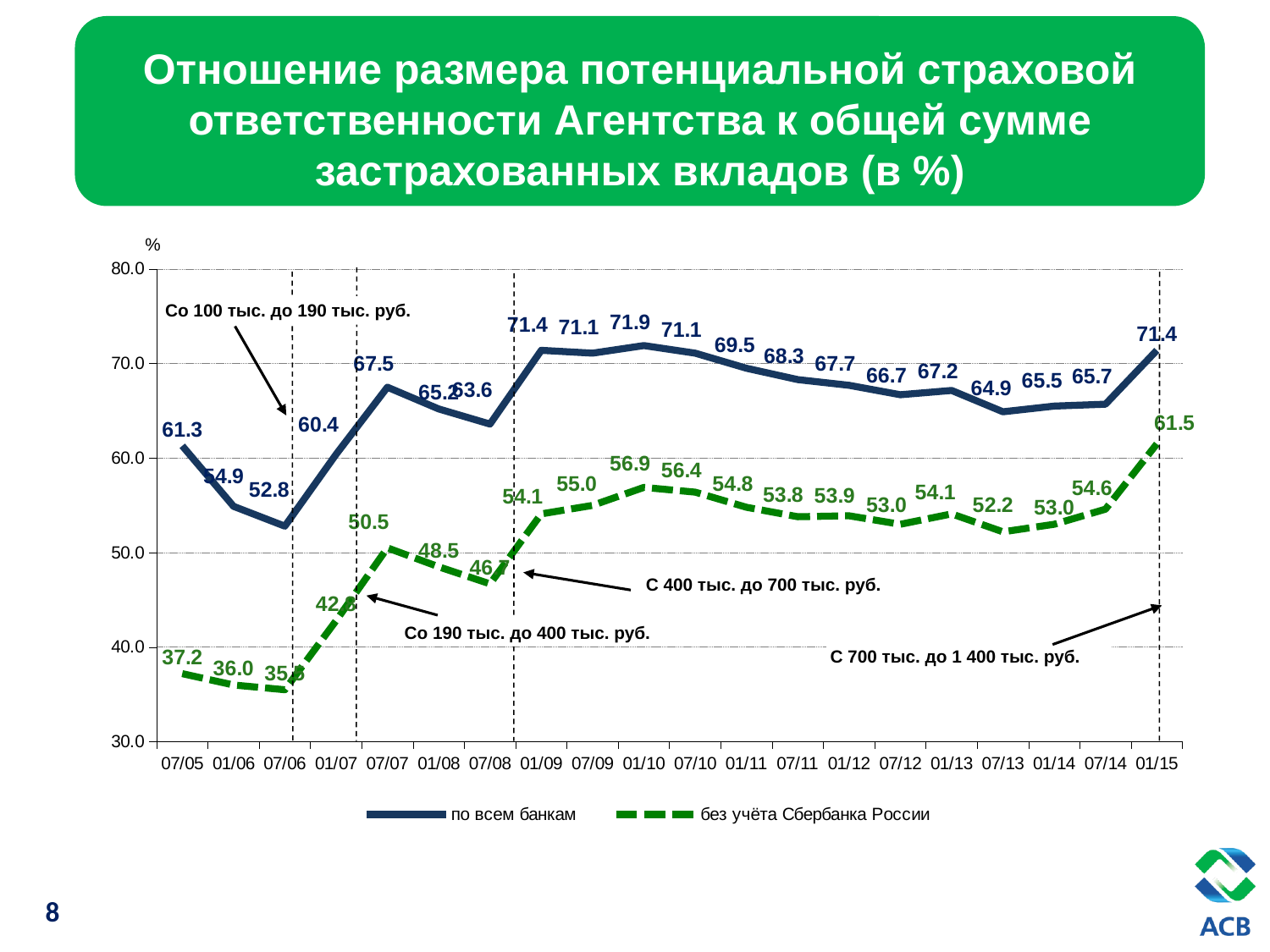
What is the value for "по всем банкам" at 07/12? 66.7 Is the value for "без учёта Сбербанка России" at 07/08 greater or less than 50.0? less At which date does the "по всем банкам" series reach its highest value? 01/10 How many dates are shown on the x axis? 20 At which date does the "без учёта Сбербанка России" series reach its lowest value? 07/06 What is the value for "без учёта Сбербанка России" at 01/15? 61.5 What kind of chart is shown on the slide? line chart What is the value for "по всем банкам" at 07/05? 61.3 What is the difference between the "по всем банкам" and "без учёта Сбербанка России" values at 01/15? 9.9 Which series is shown as a green dashed line? без учёта Сбербанка России How many series does the legend list? 2 At which date does the "по всем банкам" series reach its lowest value? 07/06